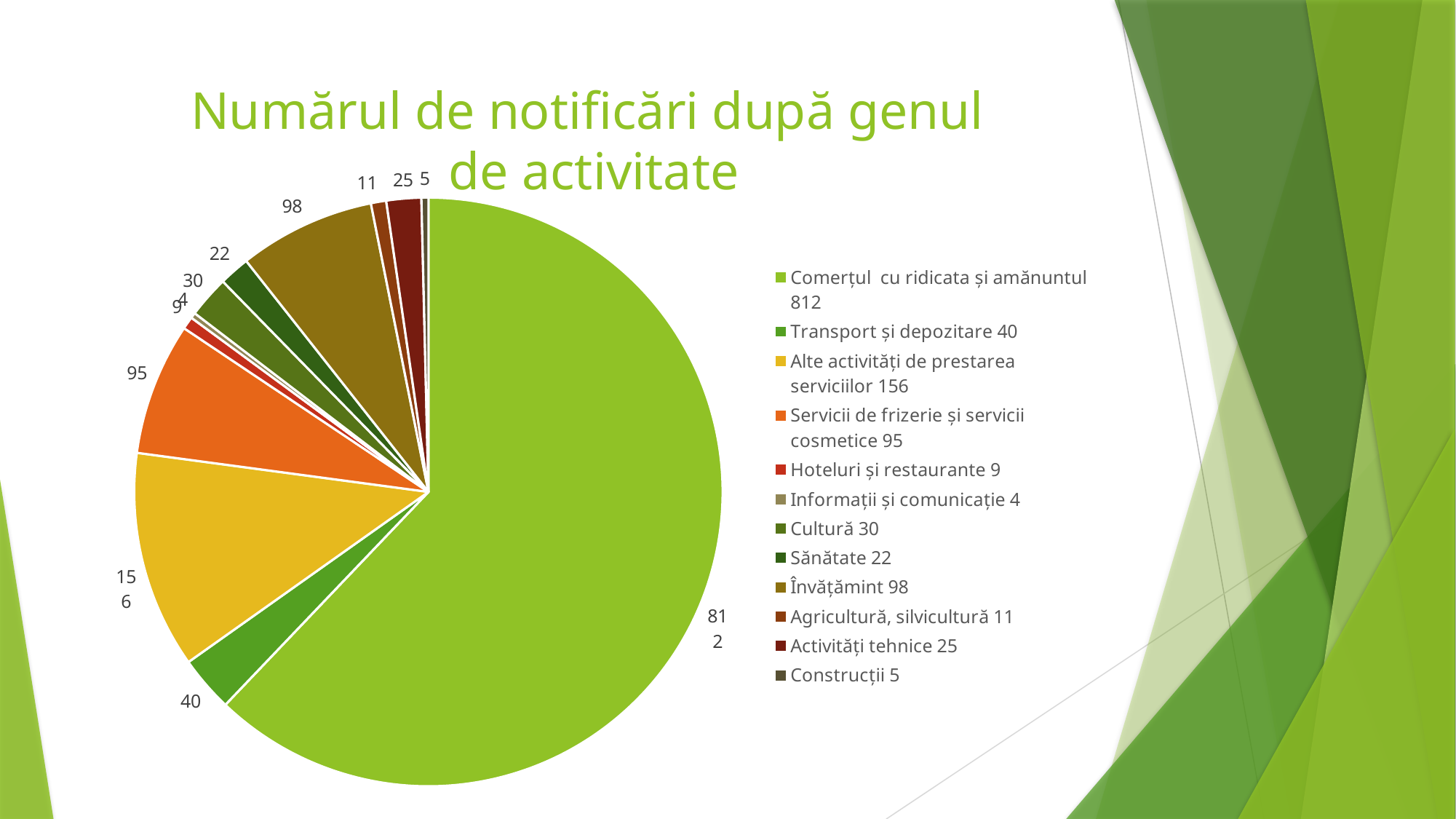
How many categories does the pie chart have? 12 What is the value for Învățămint? 98 What is the value for Hoteluri și restaurante? 9 What kind of chart is shown on the slide? pie chart What is the difference between Alte activități de prestarea serviciilor and Servicii de frizerie și servicii cosmetice? 61 What is the value for Alte activități de prestarea serviciilor? 156 What is the title of the chart? Numărul de notificări după genul de activitate Which category has the smallest value? Informații și comunicație What is the total of all the values in the pie chart? 1307 Which category has the largest slice of the pie? Comerțul cu ridicata și amănuntul What is the value for Comerțul cu ridicata și amănuntul? 812 Which is larger, Transport și depozitare or Cultură? Transport și depozitare